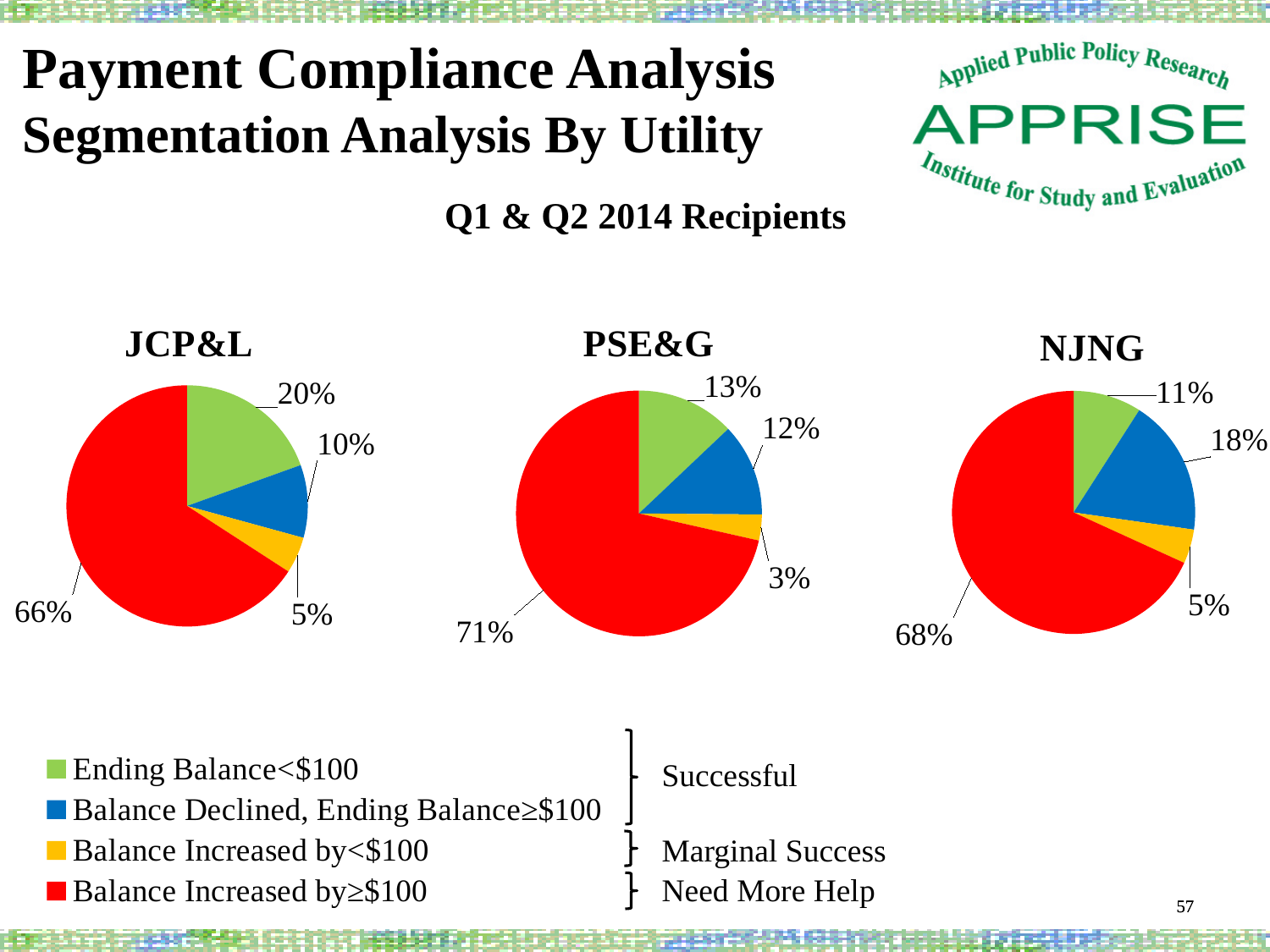
Which utility has the larger share for Ending Balance<$100, JCP&L or NJNG? JCP&L In the PSE&G chart, what percentage is shown for Balance Increased by<$100? 3% In the JCP&L chart, which category has the largest slice? Balance Increased by≥$100 In the NJNG chart, which category has the smallest slice? Balance Increased by<$100 Which colour represents Balance Increased by≥$100 in the legend? Red Which utility has the larger share for Balance Increased by≥$100, PSE&G or NJNG? PSE&G In the PSE&G chart, what percentage is shown for Ending Balance<$100? 13% How many slices does the PSE&G pie chart have? 4 In the JCP&L chart, what is the difference between the Ending Balance<$100 slice and the Balance Declined, Ending Balance≥$100 slice? 10% What type of chart is used for the JCP&L, PSE&G and NJNG data? Pie chart In the JCP&L chart, what share of recipients had Balance Increased by≥$100? 66% In the NJNG chart, what percentage is shown for Balance Declined, Ending Balance≥$100? 18%